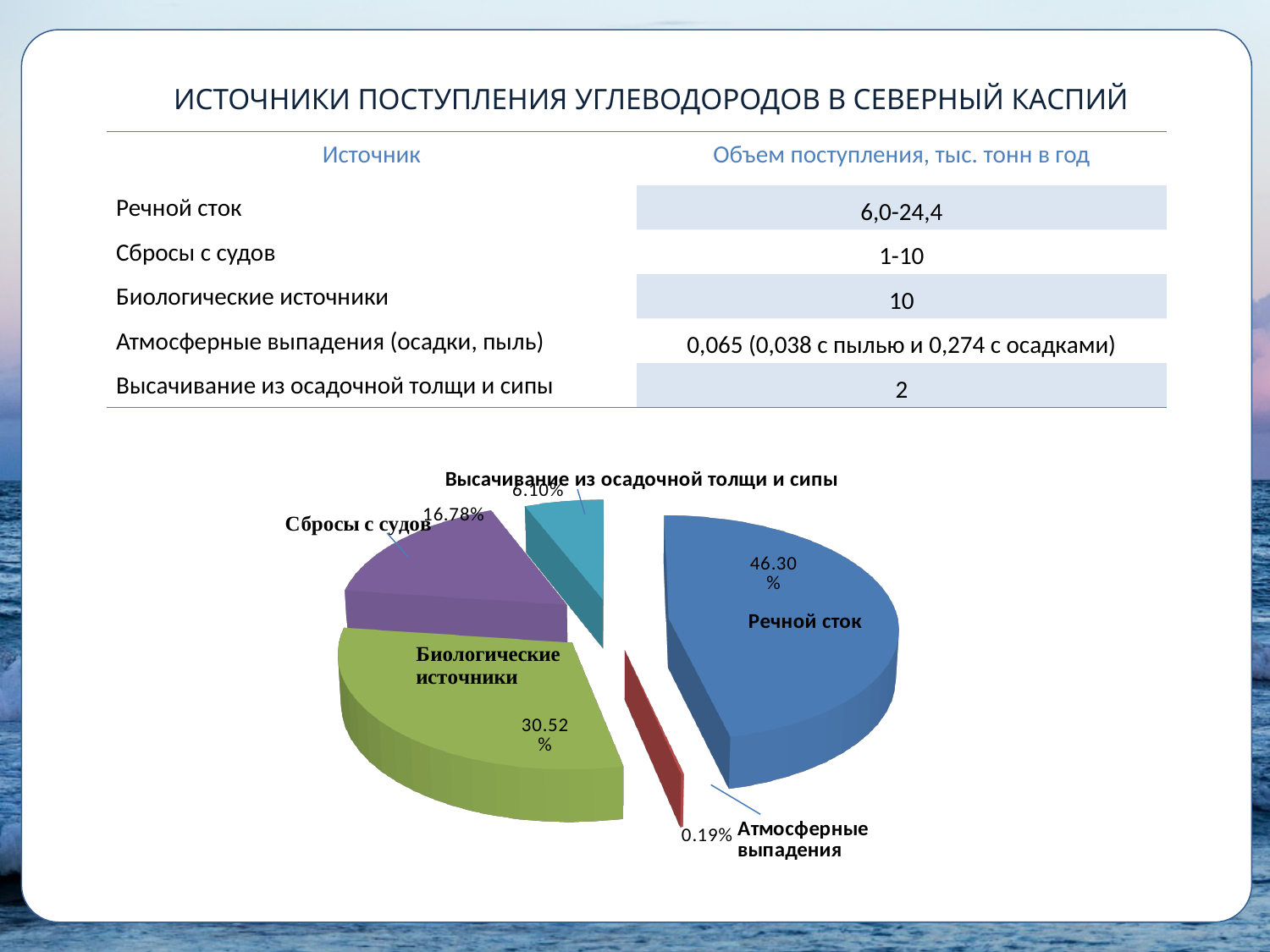
Which slice of the pie is the smallest? Атмосферные выпадения Which slice of the pie is the largest? Речной сток How many slices does the pie chart have? 5 What kind of chart is shown on the slide? pie chart What colour is the Речной сток slice in the pie chart? blue What share of the pie does Речной сток have? 46.30% What share of the pie does Высачивание из осадочной толщи и сипы have? 6.10% What share of the pie does Биологические источники have? 30.52% What share of the pie does Атмосферные выпадения have? 0.19% Which is larger in the pie chart: Сбросы с судов or Биологические источники? Биологические источники What share of the pie does Сбросы с судов have? 16.78% What is the difference in percentage points between Речной сток and Биологические источники? 15.78